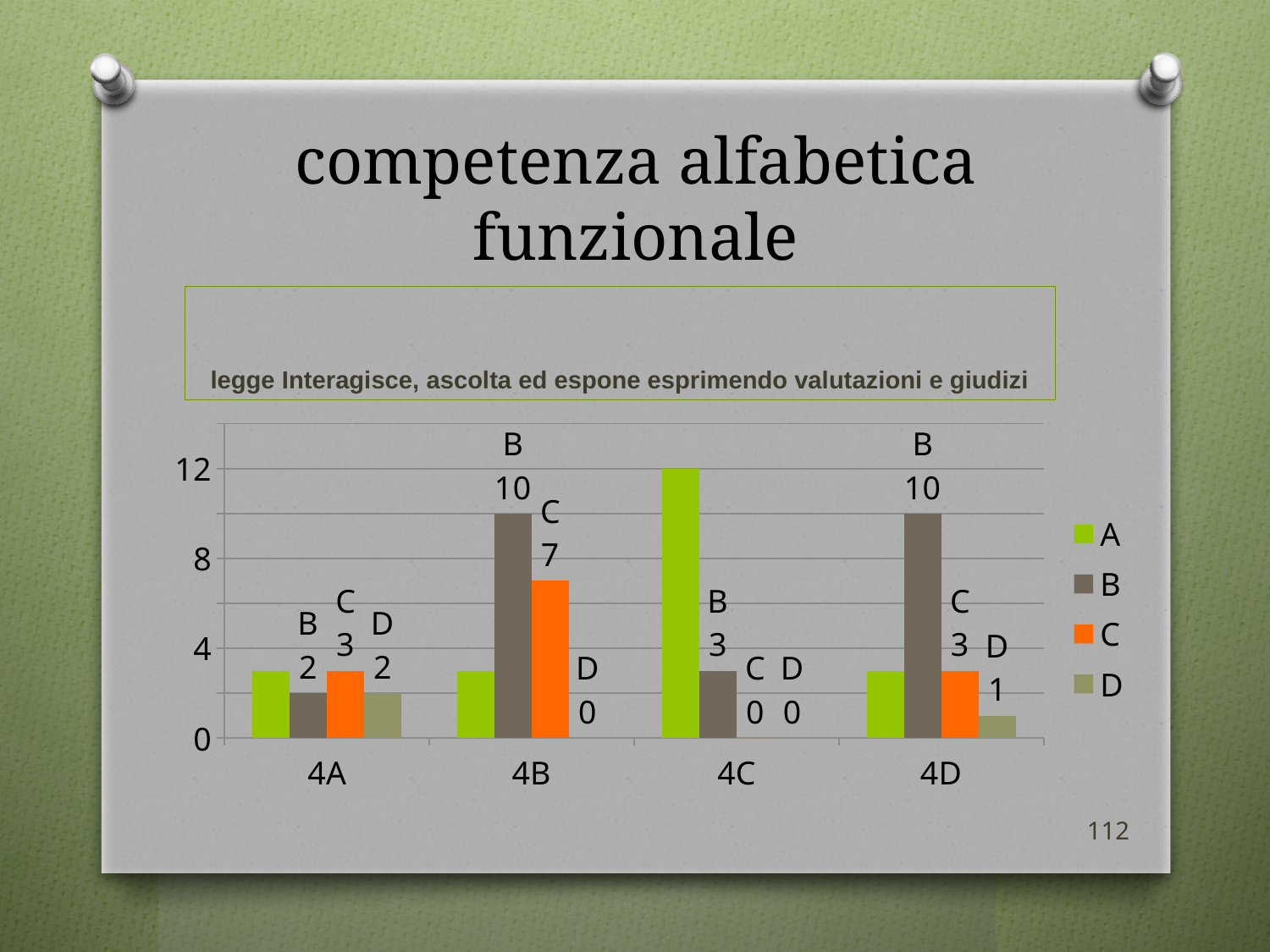
What is the value of series C for category 4B? 7 How many series does the legend list? 4 What is the difference between the series B values for 4B and 4A? 8 What is the text in the box above the chart? legge Interagisce, ascolta ed espone esprimendo valutazioni e giudizi How many categories are shown on the x axis? 4 Is the value of series A for category 4C greater or less than 8? greater Which is larger: series B for 4D or series B for 4C? series B for 4D What is the value of series D for category 4D? 1 What is the value of series C for category 4C? 0 Which category has the highest value for series C? 4B What kind of chart is shown on the slide? bar chart What is the value of series B for category 4B? 10